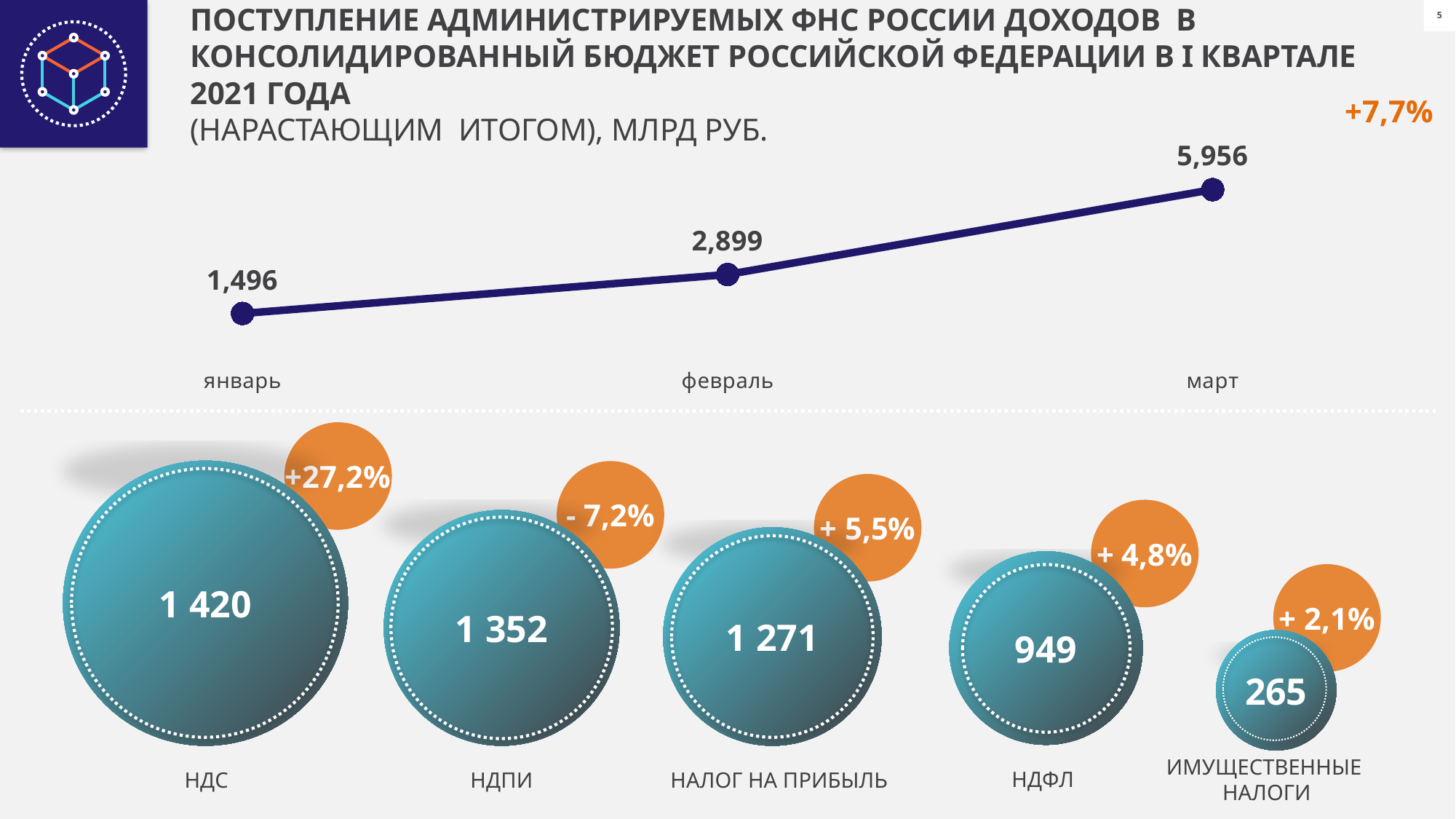
In the line chart at the top of the slide, how many data points are plotted? 3 In the line chart at the top of the slide, what is the difference between the values for март and февраль? 3,057 In the line chart at the top of the slide, what is the value for февраль? 2,899 In the circles at the bottom of the slide, what percentage change is shown next to НДФЛ? + 4,8% In the circles at the bottom of the slide, which category has the largest value? НДС What kind of chart is shown at the top of the slide? line chart In the circles at the bottom of the slide, what is the value shown for НДПИ? 1 352 In the line chart at the top of the slide, what is the value for январь? 1,496 In the line chart at the top of the slide, which month has the highest value? март In the line chart at the top of the slide, which month has the lowest value? январь In the line chart at the top of the slide, what is the value for март? 5,956 In the line chart at the top of the slide, do the values rise or fall from январь to март? rise